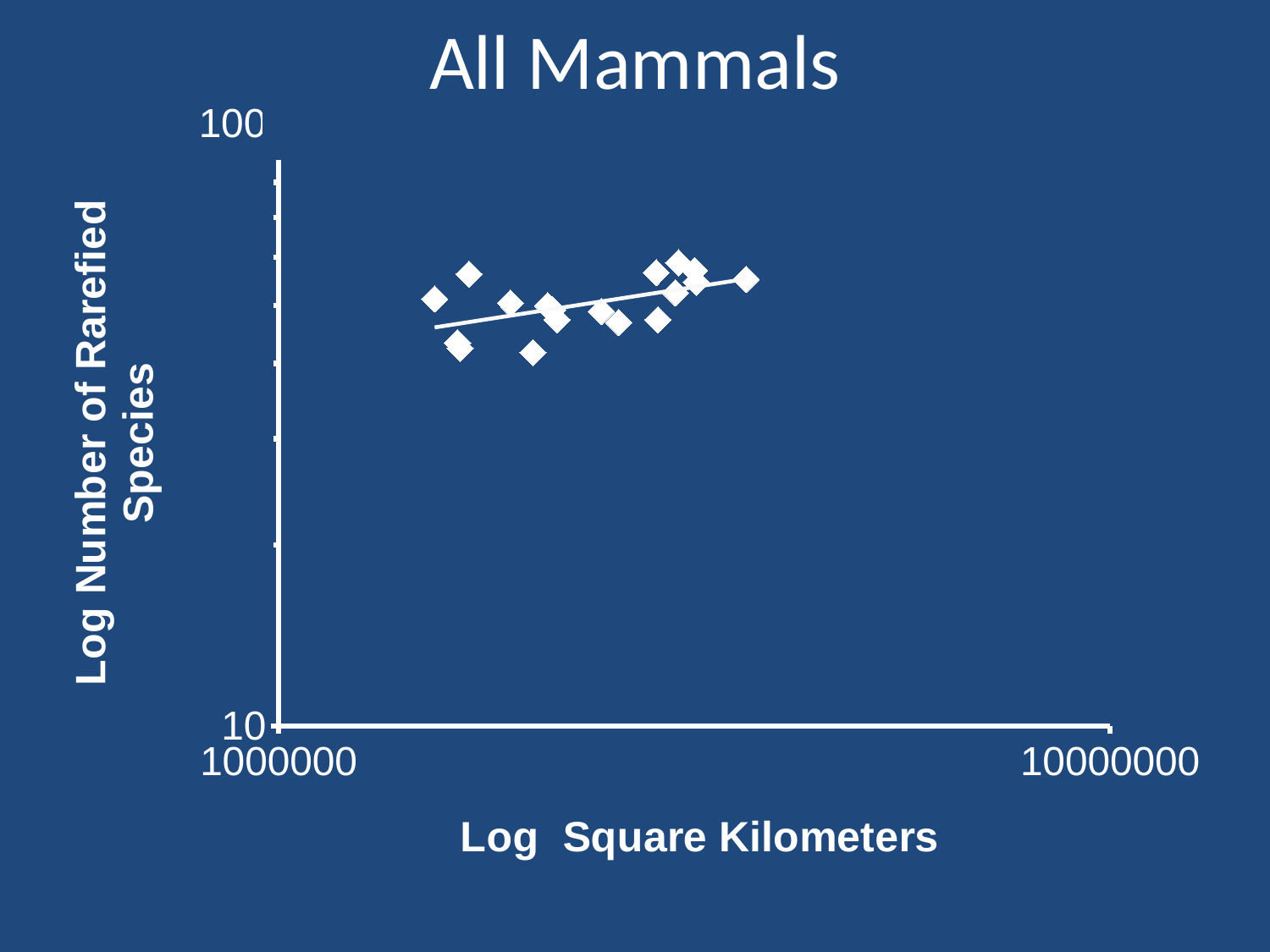
What is the highest value printed on the x axis? 10000000 Does the trend line rise or fall as Log Square Kilometers increases? rises What kind of chart is shown on the slide? scatter plot What is the lowest value printed on the y axis? 10 What is the title of the chart? All Mammals Are all the plotted points greater or less than 100 on the y axis? less Are all the plotted points greater or less than 10 on the y axis? greater